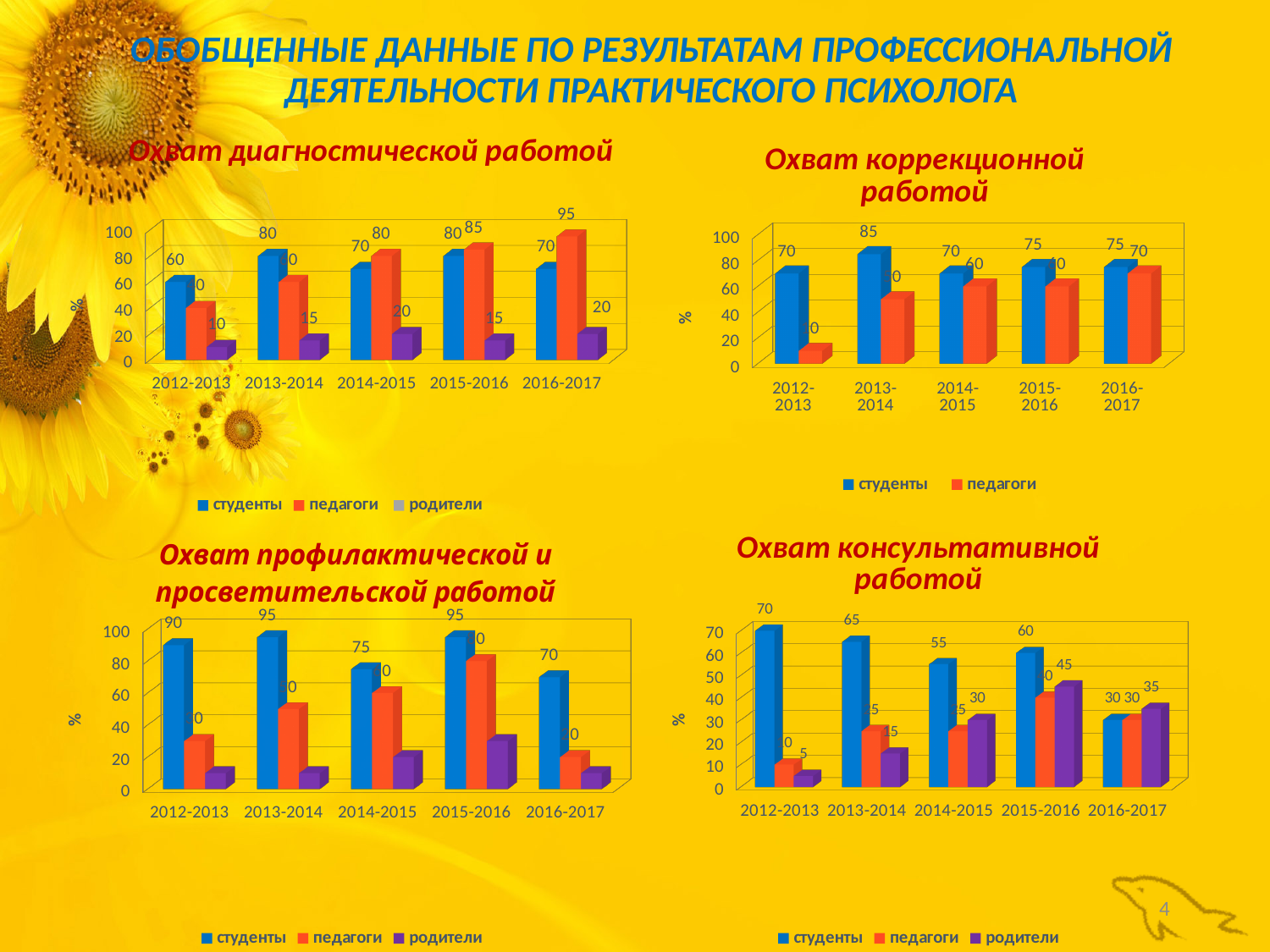
In the chart 'Охват коррекционной работой', in which year is the value for студенты highest? 2013-2014 In the chart 'Охват коррекционной работой', what is the value for педагоги in 2016-2017? 70 What kind of chart is 'Охват консультативной работой'? bar chart In the chart 'Охват консультативной работой', what is the value for родители in 2015-2016? 45 In the chart 'Охват диагностической работой', what is the difference between педагоги and студенты in 2016-2017? 25 In the chart 'Охват диагностической работой', what is the value for педагоги in 2016-2017? 95 In the chart 'Охват диагностической работой', what is the value for студенты in 2012-2013? 60 In the chart 'Охват консультативной работой', does the value for студенты rise or fall from 2012-2013 to 2016-2017? fall In the chart 'Охват профилактической и просветительской работой', how many year categories are shown on the x axis? 5 In the chart 'Охват коррекционной работой', is the value for педагоги in 2012-2013 greater or less than 20? less In the chart 'Охват профилактической и просветительской работой', what is the value for студенты in 2014-2015? 75 In the chart 'Охват диагностической работой', how many series does the legend list? 3